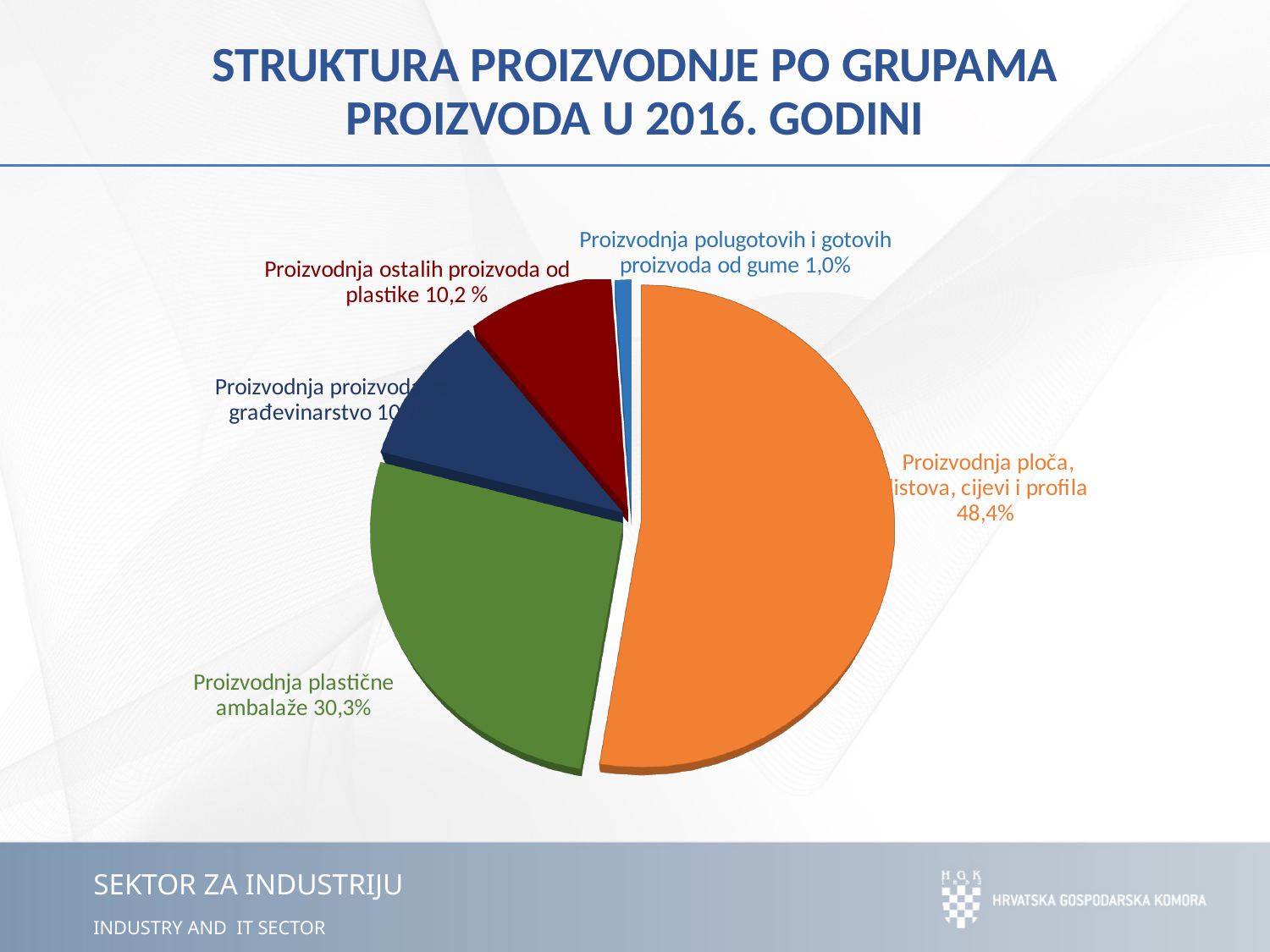
What is the title of the slide containing the pie chart? STRUKTURA PROIZVODNJE PO GRUPAMA PROIZVODA U 2016. GODINI Which has a larger share: 'Proizvodnja plastične ambalaže' or 'Proizvodnja ostalih proizvoda od plastike'? Proizvodnja plastične ambalaže What share does 'Proizvodnja polugotovih i gotovih proizvoda od gume' have in the pie chart? 1,0% What kind of chart is shown on the slide? pie chart What share does 'Proizvodnja ploča, listova, cijevi i profila' have in the pie chart? 48,4% What share does 'Proizvodnja ostalih proizvoda od plastike' have in the pie chart? 10,2 % How many slices does the pie chart have? 5 What colour is the largest slice of the pie chart? orange What share does 'Proizvodnja plastične ambalaže' have in the pie chart? 30,3% What is the difference in share between 'Proizvodnja ploča, listova, cijevi i profila' and 'Proizvodnja plastične ambalaže'? 18,1% Which product group has the smallest share in the pie chart? Proizvodnja polugotovih i gotovih proizvoda od gume Which product group has the largest share in the pie chart? Proizvodnja ploča, listova, cijevi i profila